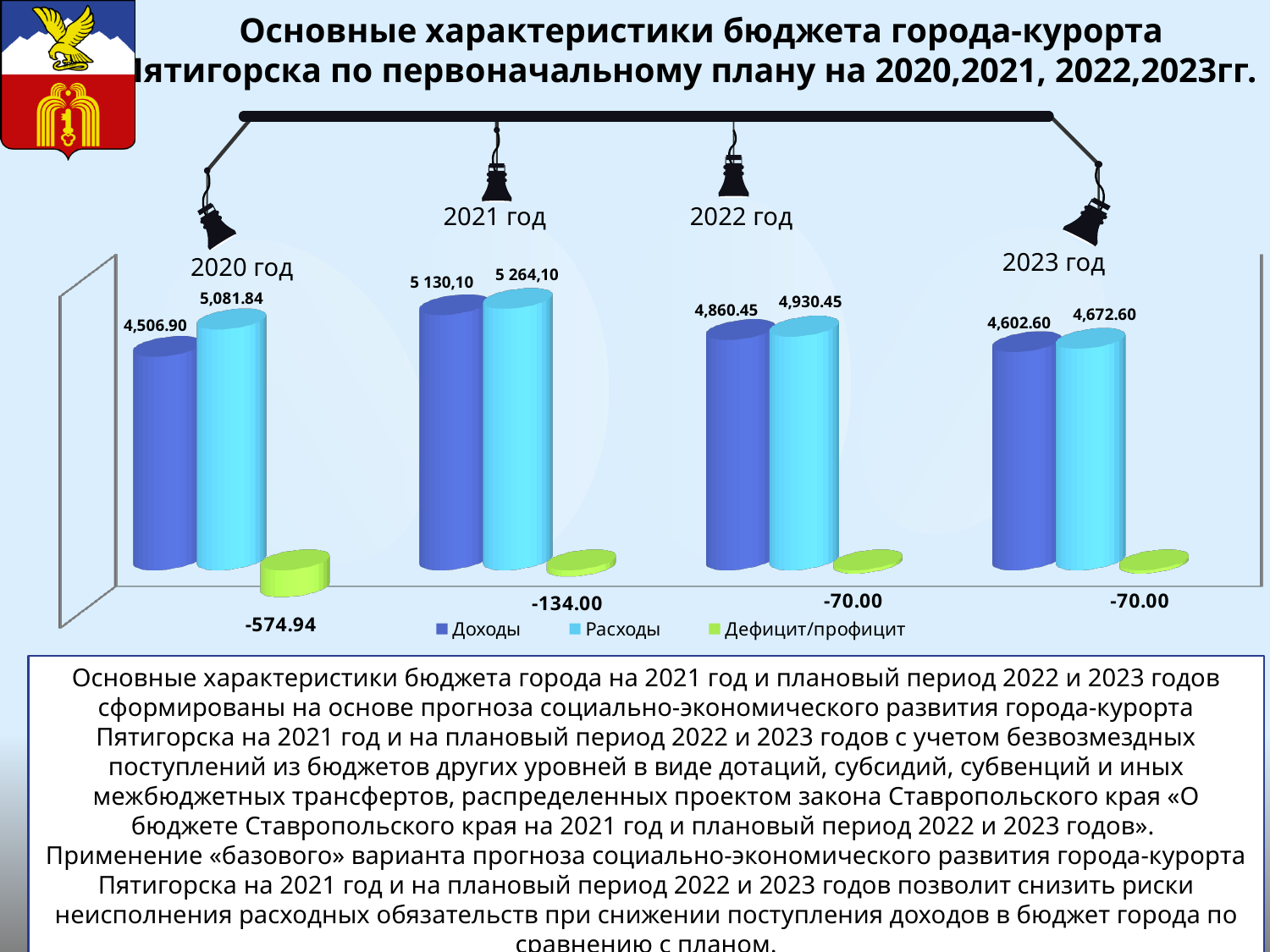
What is the difference between Расходы and Доходы for 2022 год? 70.00 Which year has the lowest value of Расходы? 2023 год What kind of chart is shown on the slide? Bar chart What is the value of Доходы for 2020 год? 4,506.90 How many years are shown on the chart? 4 Which year has the highest value of Доходы? 2021 год What is the value of Расходы for 2021 год? 5 264,10 How many series does the legend list? 3 Which is larger for 2020 год: Доходы or Расходы? Расходы What is the value of Доходы for 2023 год? 4,602.60 What is the value of Дефицит/профицит for 2020 год? -574.94 Which series is shown in green in the legend? Дефицит/профицит